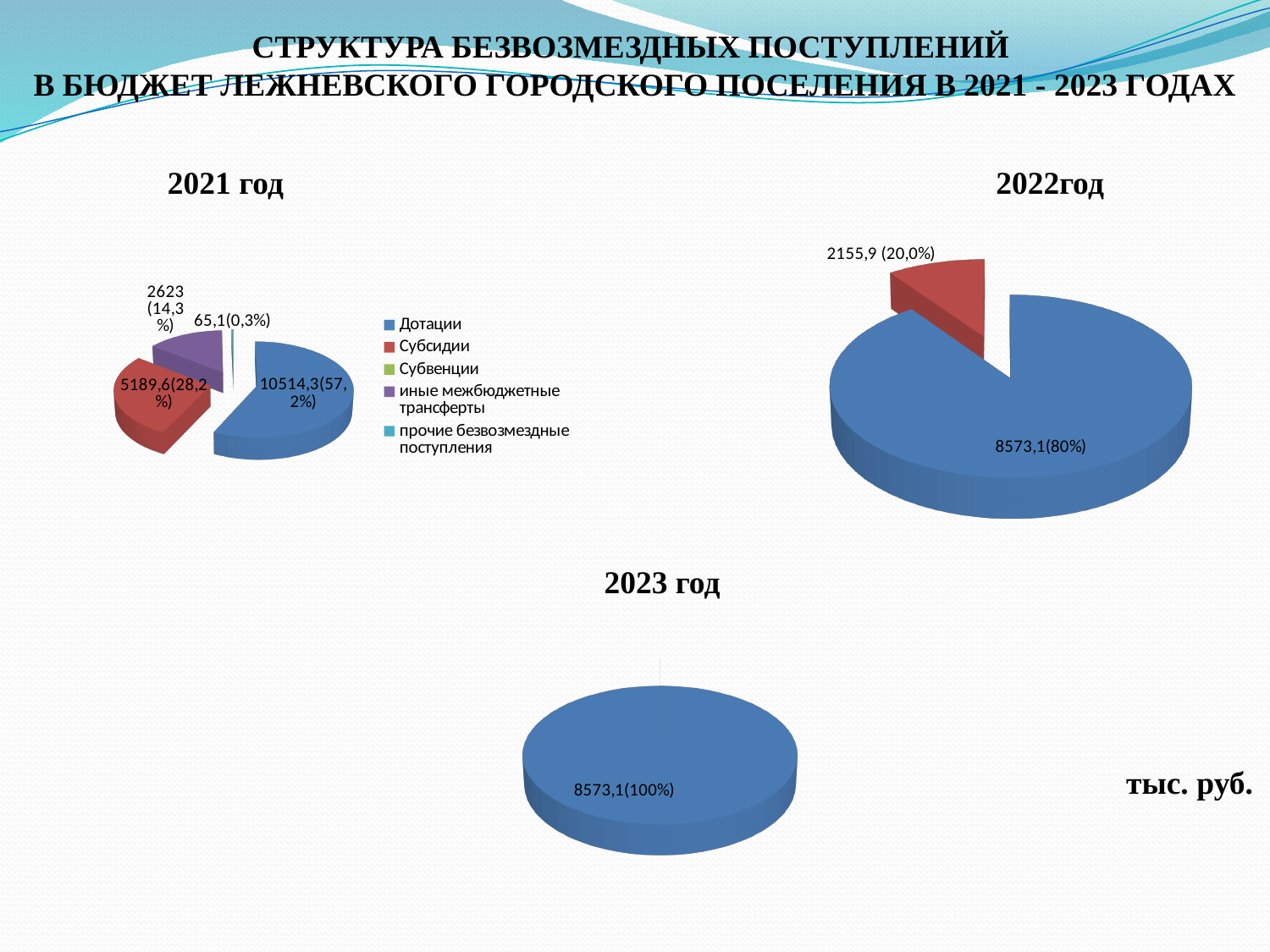
What kind of chart is used for the 2021 год chart? pie chart In the 2023 год chart, what is the value shown on the single slice? 8573,1 In the 2022год chart, how many slices does the pie have? 2 In the 2021 год chart, which is larger: Дотации or Субсидии? Дотации In the 2021 год chart, what is the value for Дотации? 10514,3 In the 2021 год chart, what is the value for Субсидии? 5189,6 In the 2021 год chart, what share of the pie does иные межбюджетные трансферты take? 14,3% In the 2021 год chart, what share of the pie does Дотации take? 57,2% In the 2021 год chart, which category has the largest slice? Дотации